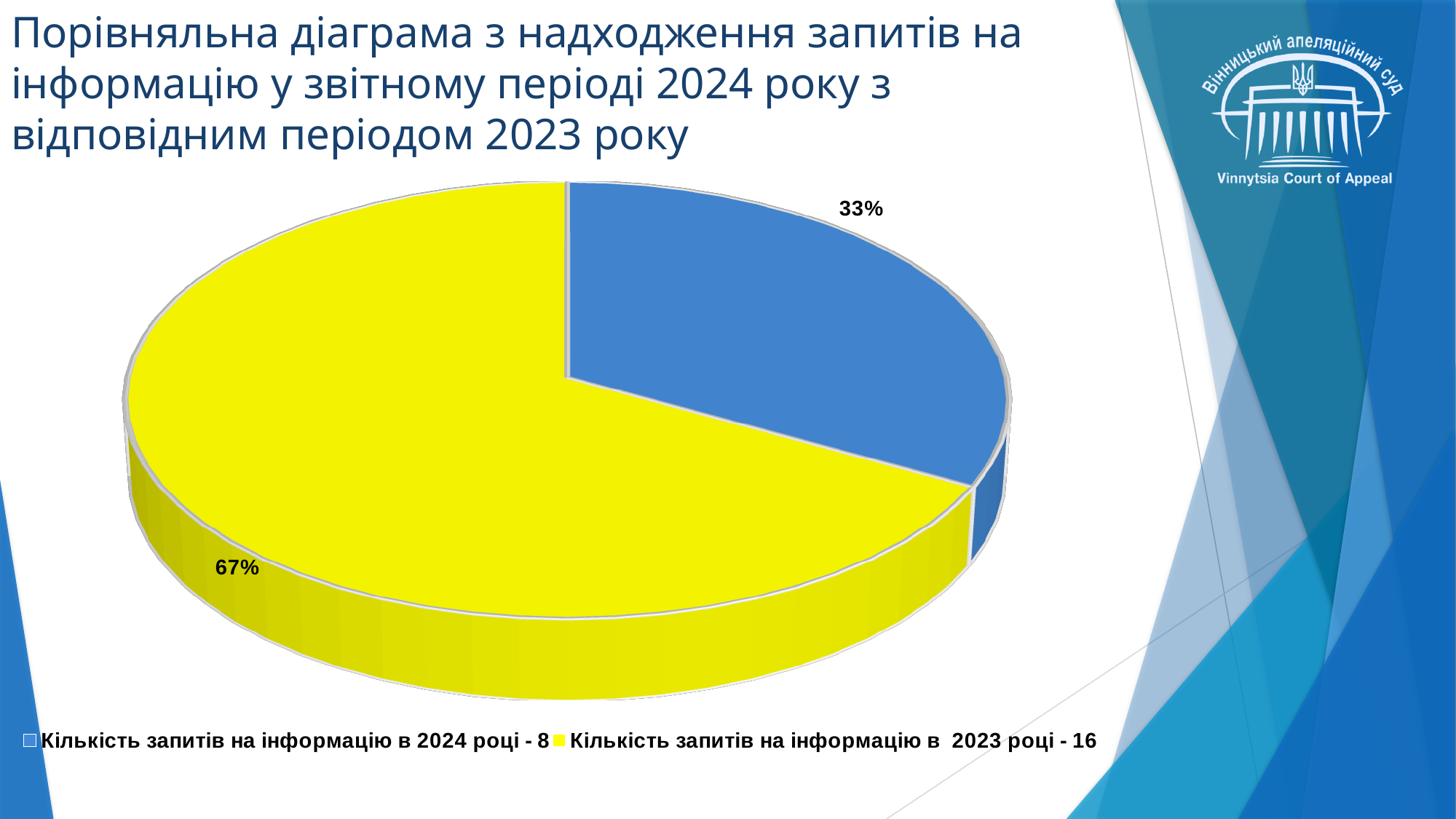
How many entries does the legend list? 2 What colour is the slice representing requests for information in 2023? yellow According to the legend, how many requests for information were received in 2024? 8 What percentage share is shown for the blue slice (requests for information in 2024)? 33% Which slice is the smallest in the pie chart? Кількість запитів на інформацію в 2024 році - 8 According to the legend, how many requests for information were received in 2023? 16 What percentage share is shown for the yellow slice (requests for information in 2023)? 67% Which is larger: the share for 2024 or the share for 2023? 2023 How many slices does the pie chart have? 2 What is the difference between the number of requests in 2023 and in 2024, as given in the legend? 8 What kind of chart is shown on the slide? pie chart Which slice is the largest in the pie chart? Кількість запитів на інформацію в 2023 році - 16